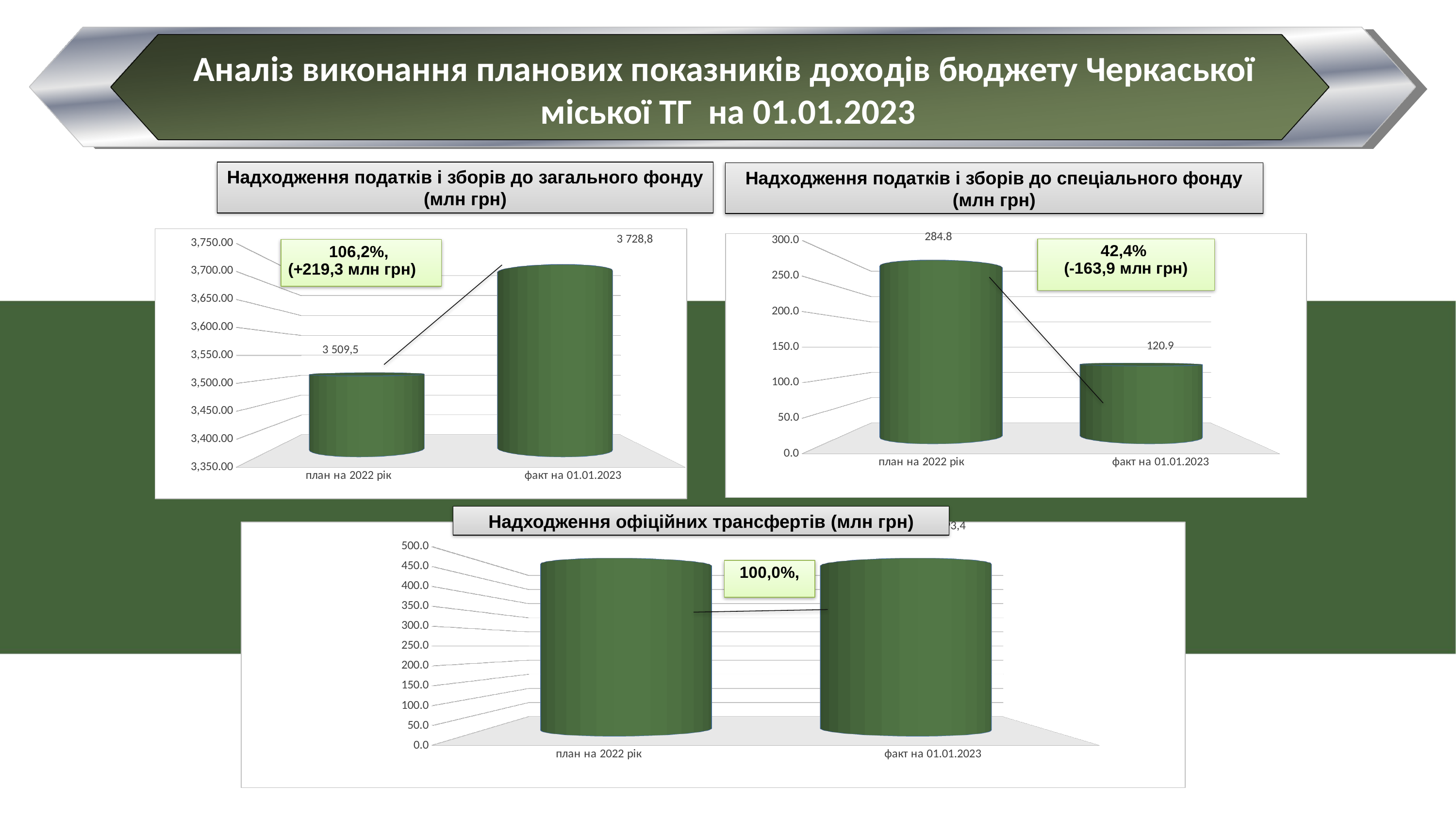
In the chart 'Надходження податків і зборів до загального фонду (млн грн)', what is the value for 'план на 2022 рік'? 3 509,5 In the chart 'Надходження податків і зборів до спеціального фонду (млн грн)', what is the difference between 'план на 2022 рік' and 'факт на 01.01.2023'? 163.9 How many categories are shown in the chart 'Надходження офіційних трансфертів (млн грн)'? 2 In the chart 'Надходження податків і зборів до загального фонду (млн грн)', is the value for 'факт на 01.01.2023' larger or smaller than the value for 'план на 2022 рік'? larger In the chart 'Надходження офіційних трансфертів (млн грн)', is the value for 'план на 2022 рік' greater or less than 400? greater In the chart 'Надходження податків і зборів до спеціального фонду (млн грн)', which category has the higher value? план на 2022 рік In the chart 'Надходження податків і зборів до спеціального фонду (млн грн)', what is the value for 'факт на 01.01.2023'? 120.9 In the chart 'Надходження податків і зборів до загального фонду (млн грн)', what is the value for 'факт на 01.01.2023'? 3 728,8 What percentage is shown in the callout on the chart 'Надходження офіційних трансфертів (млн грн)'? 100,0% In the chart 'Надходження податків і зборів до загального фонду (млн грн)', which category has the lower value? план на 2022 рік What kind of chart is 'Надходження податків і зборів до спеціального фонду (млн грн)'? bar chart In the chart 'Надходження податків і зборів до спеціального фонду (млн грн)', what is the value for 'план на 2022 рік'? 284.8